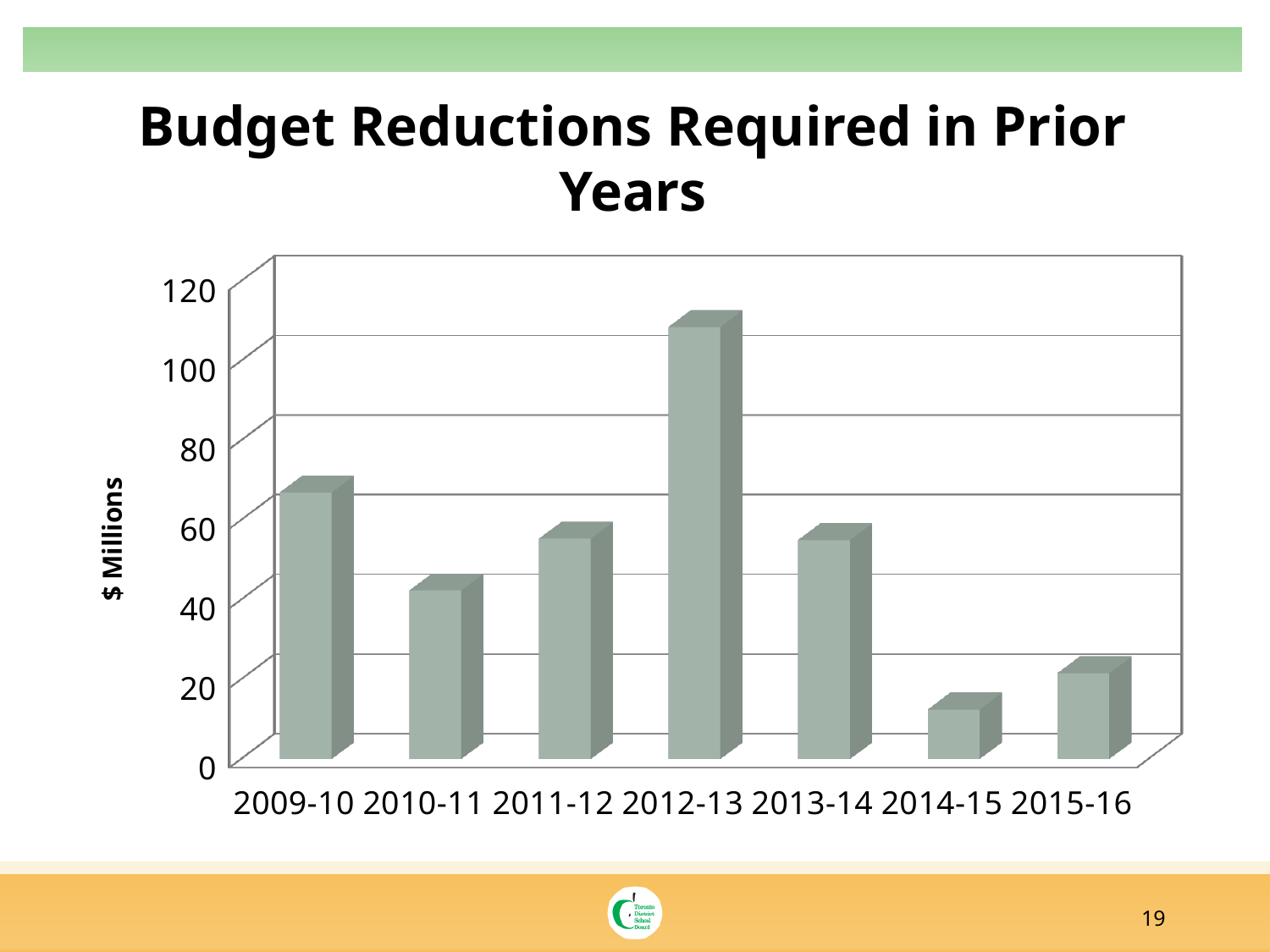
Is the value for 2009-10 greater or less than 60? greater How many years are shown on the x axis of the chart? 7 Is the value for 2014-15 greater or less than 20? less What kind of chart is shown on the slide? bar chart Is the value for 2012-13 greater or less than 100? greater What is the label on the vertical axis of the chart? $ Millions Which year has the larger budget reduction, 2009-10 or 2010-11? 2009-10 Which year has the lowest budget reduction? 2014-15 What is the title of the chart? Budget Reductions Required in Prior Years Which year has the highest budget reduction? 2012-13 Does the value rise or fall from 2012-13 to 2013-14? fall